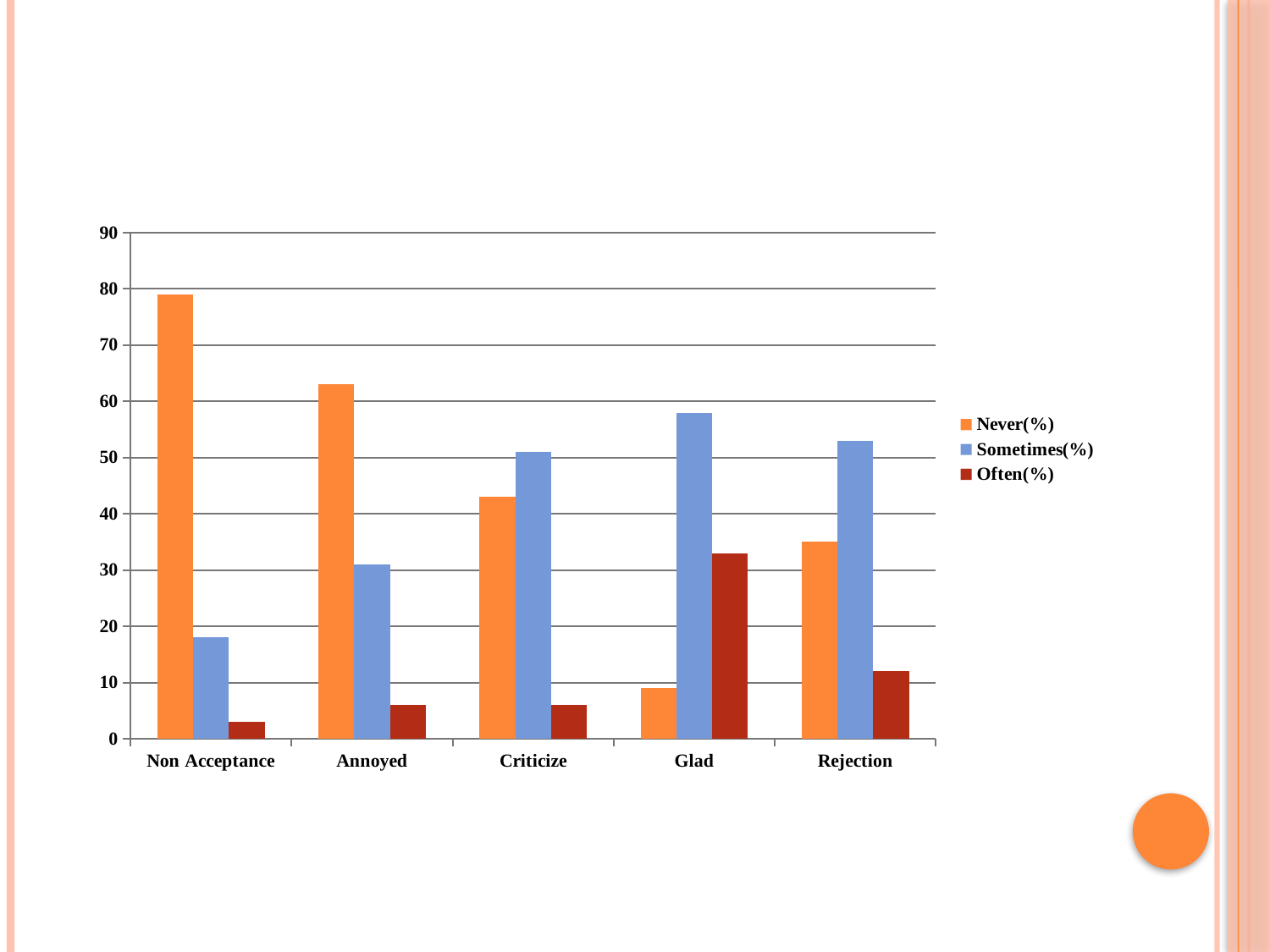
Is the Never(%) value for Glad greater or less than 20? less Is the Never(%) value for Non Acceptance greater or less than 70? greater What kind of chart is shown on the slide? bar chart Which category has the highest Sometimes(%) bar? Glad Is the Sometimes(%) value for Glad greater or less than 50? greater Which category has the lowest Often(%) bar? Non Acceptance How many categories are shown on the x axis? 5 How many series does the legend list? 3 Which category has the highest Never(%) bar? Non Acceptance Which category has the lowest Never(%) bar? Glad For Criticize, which is larger: Never(%) or Sometimes(%)? Sometimes(%) For Annoyed, which is larger: Never(%) or Sometimes(%)? Never(%)